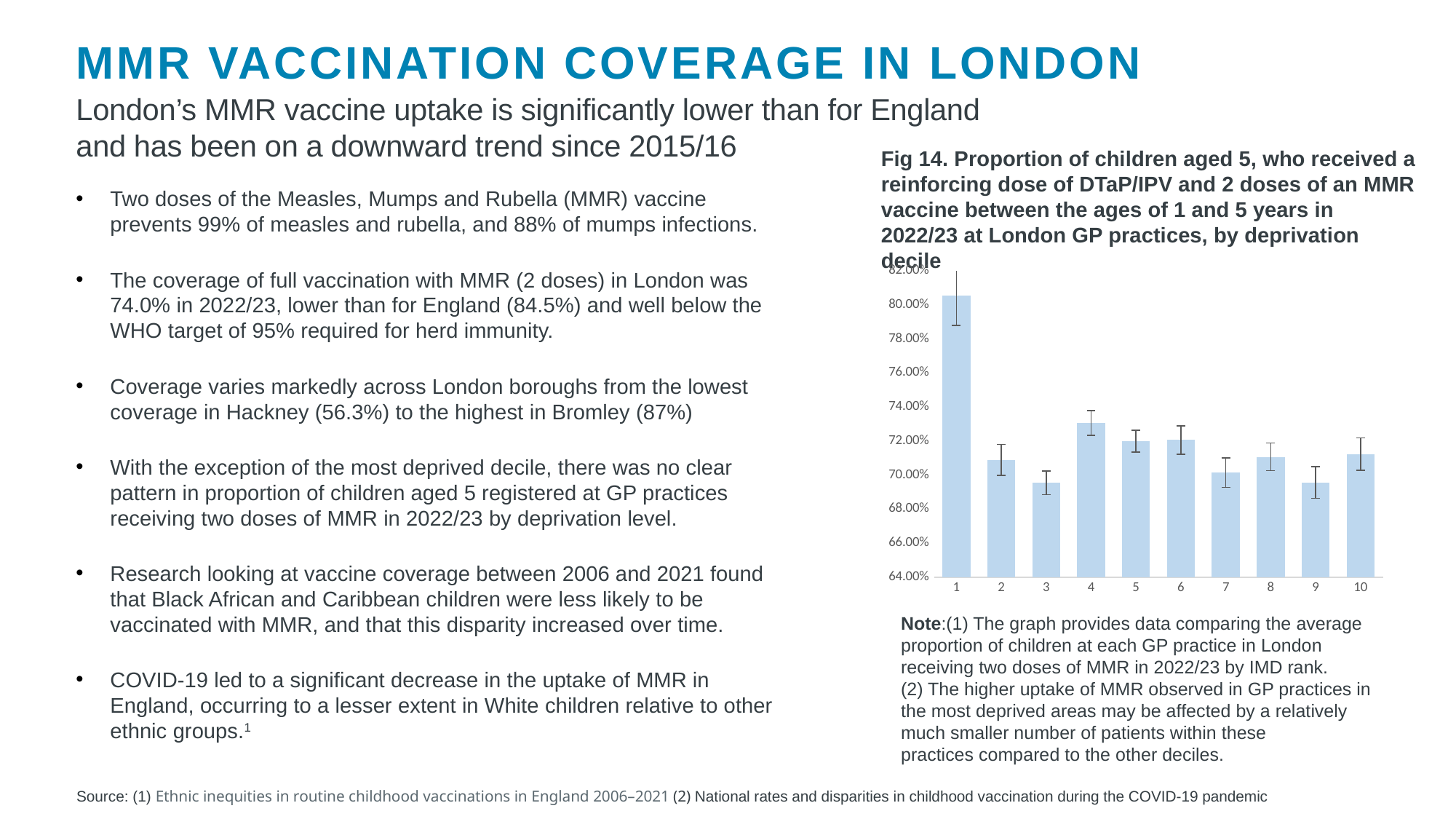
What is the lowest value shown on the y axis of Fig 14? 64.00% In Fig 14, is the value for decile 10 greater or less than 74.00%? less How many deprivation deciles are plotted on the x axis of Fig 14? 10 In Fig 14, is the value for decile 1 greater or less than 78.00%? greater In Fig 14, is the value for decile 2 greater or less than 72.00%? less In Fig 14, which has the larger value, decile 3 or decile 4? decile 4 Which deprivation decile has the highest proportion of children receiving two MMR doses in Fig 14? 1 What year does the title of Fig 14 say the data refers to? 2022/23 In Fig 14, which has the larger value, decile 1 or decile 2? decile 1 What kind of chart is shown in Fig 14? bar chart